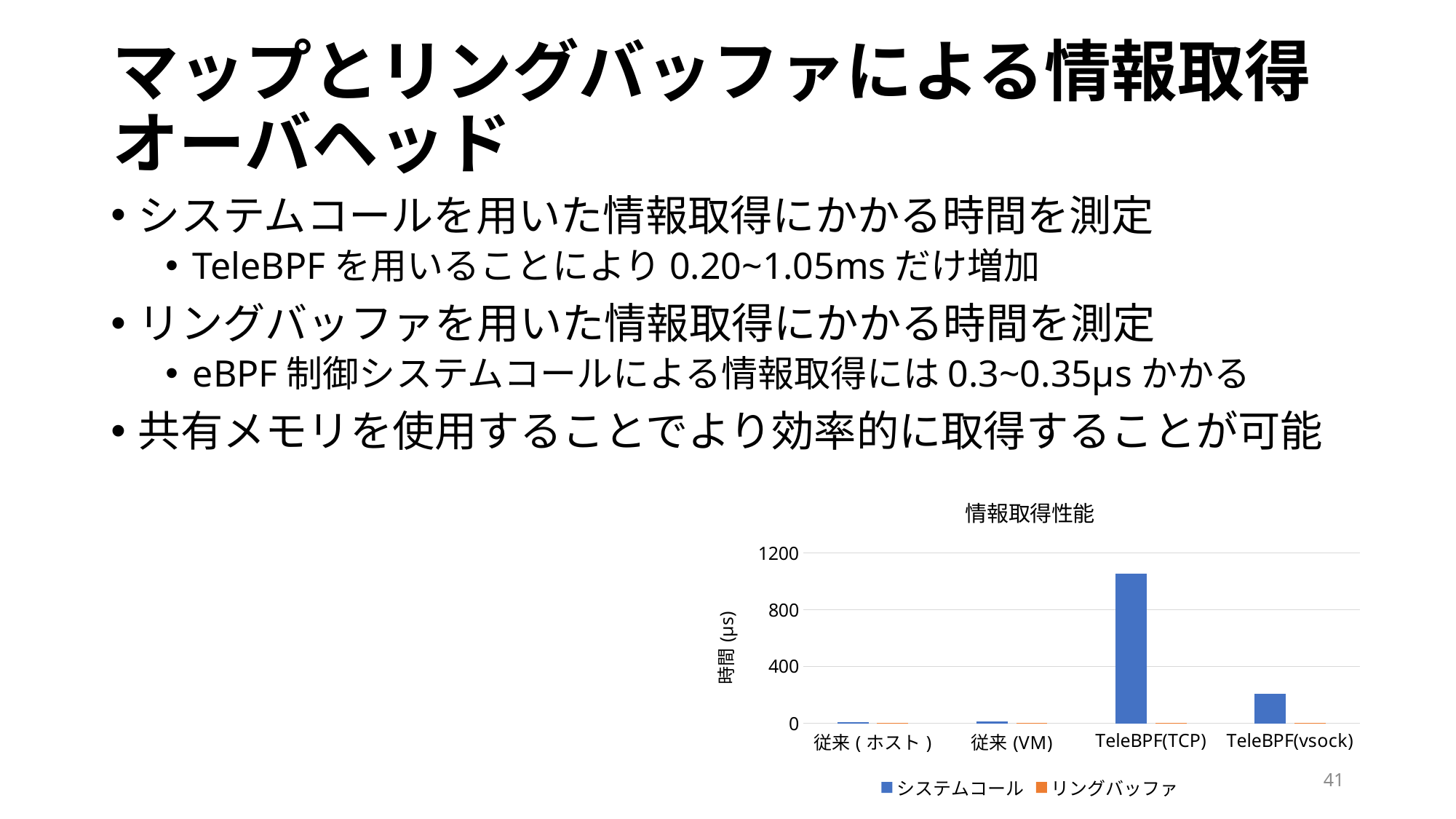
How many series does the chart's legend list? 2 Is the システムコール value for TeleBPF(TCP) greater or less than 800? greater What is the highest value shown on the chart's y axis? 1200 How many categories are shown on the x axis of the chart? 4 Is the システムコール value for TeleBPF(vsock) greater or less than 400? less Is the システムコール value for 従来 (VM) greater or less than 400? less Which has the larger システムコール value, TeleBPF(TCP) or TeleBPF(vsock)? TeleBPF(TCP) What kind of chart is shown on the slide? bar chart What is the label of the chart's y axis? 時間 (μs) Which has the larger システムコール value, 従来 (ホスト) or TeleBPF(vsock)? TeleBPF(vsock) Which category has the highest システムコール value in the chart? TeleBPF(TCP) What is the title of the chart? 情報取得性能